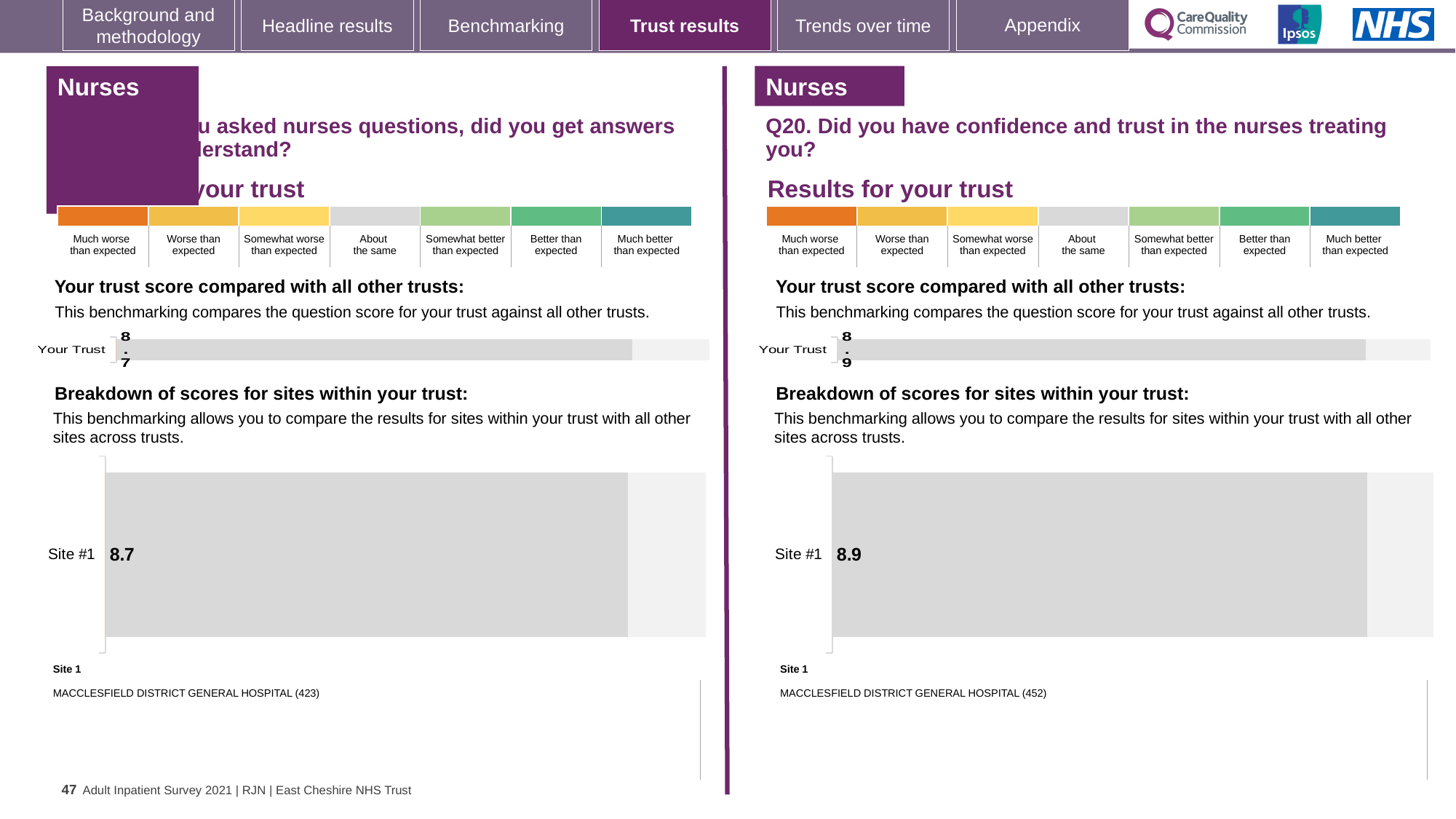
On the left panel, what is the score for Site #1 in the 'Breakdown of scores for sites within your trust' chart? 8.7 On the right panel (Q20), is the Your Trust score greater or less than 8? greater How many sites are shown in the 'Breakdown of scores for sites within your trust' chart on the right panel (Q20)? 1 On the right panel (Q20), what is the score for Site #1 in the 'Breakdown of scores for sites within your trust' chart? 8.9 What is the difference between the Your Trust score on the right panel (Q20) and the Your Trust score on the left panel? 0.2 Which is larger: the Site #1 score on the left panel or the Site #1 score on the right panel (Q20)? Right panel (Q20) On the left panel, what is the score shown for Your Trust in the 'Your trust score compared with all other trusts' chart? 8.7 On the right panel (Q20. Did you have confidence and trust in the nurses treating you?), what is the score shown for Your Trust? 8.9 Which hospital is listed as Site 1 on the right panel (Q20)? MACCLESFIELD DISTRICT GENERAL HOSPITAL (452) How many benchmark categories are shown in the colour scale on the right panel (Q20), from 'Much worse than expected' to 'Much better than expected'? 7 What kind of chart is used to show the Site #1 score on the left panel? Bar chart